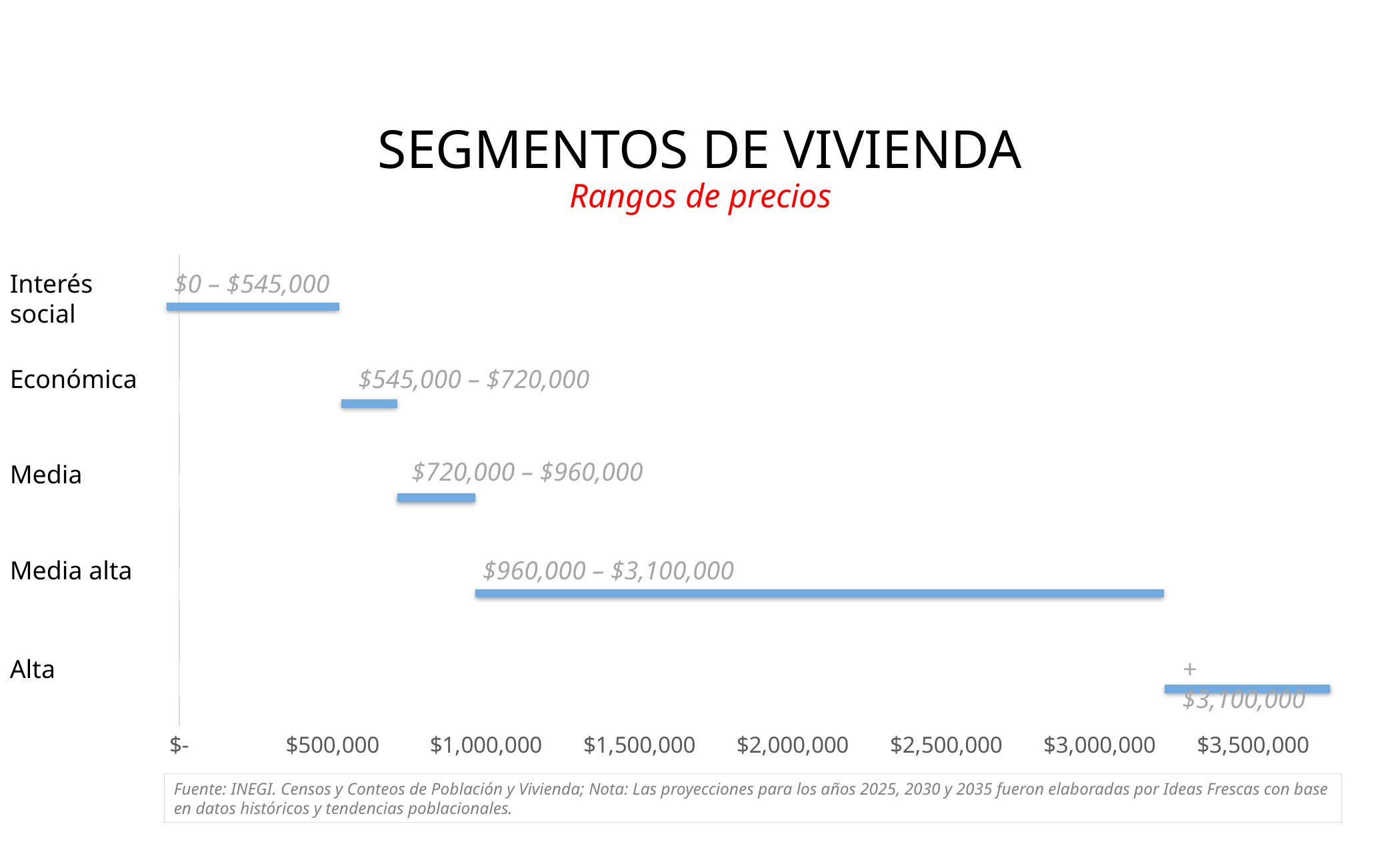
Which segment has the widest price range among those with both limits printed? Media alta Is the upper limit of the Media segment greater or less than $1,000,000? less What price range is shown for the Media alta segment? $960,000 – $3,100,000 What price range is shown for the Interés social segment? $0 – $545,000 What is the width of the Media segment's price range (upper limit minus lower limit)? $240,000 What kind of chart is used to show the price ranges? Bar chart What is the lower price limit of the Alta segment? $3,100,000 What is the subtitle of the chart shown in red? Rangos de precios What price range is shown for the Media segment? $720,000 – $960,000 What price range is shown for the Económica segment? $545,000 – $720,000 Which segment has the narrowest price range? Económica How many housing segments are shown on the chart? 5